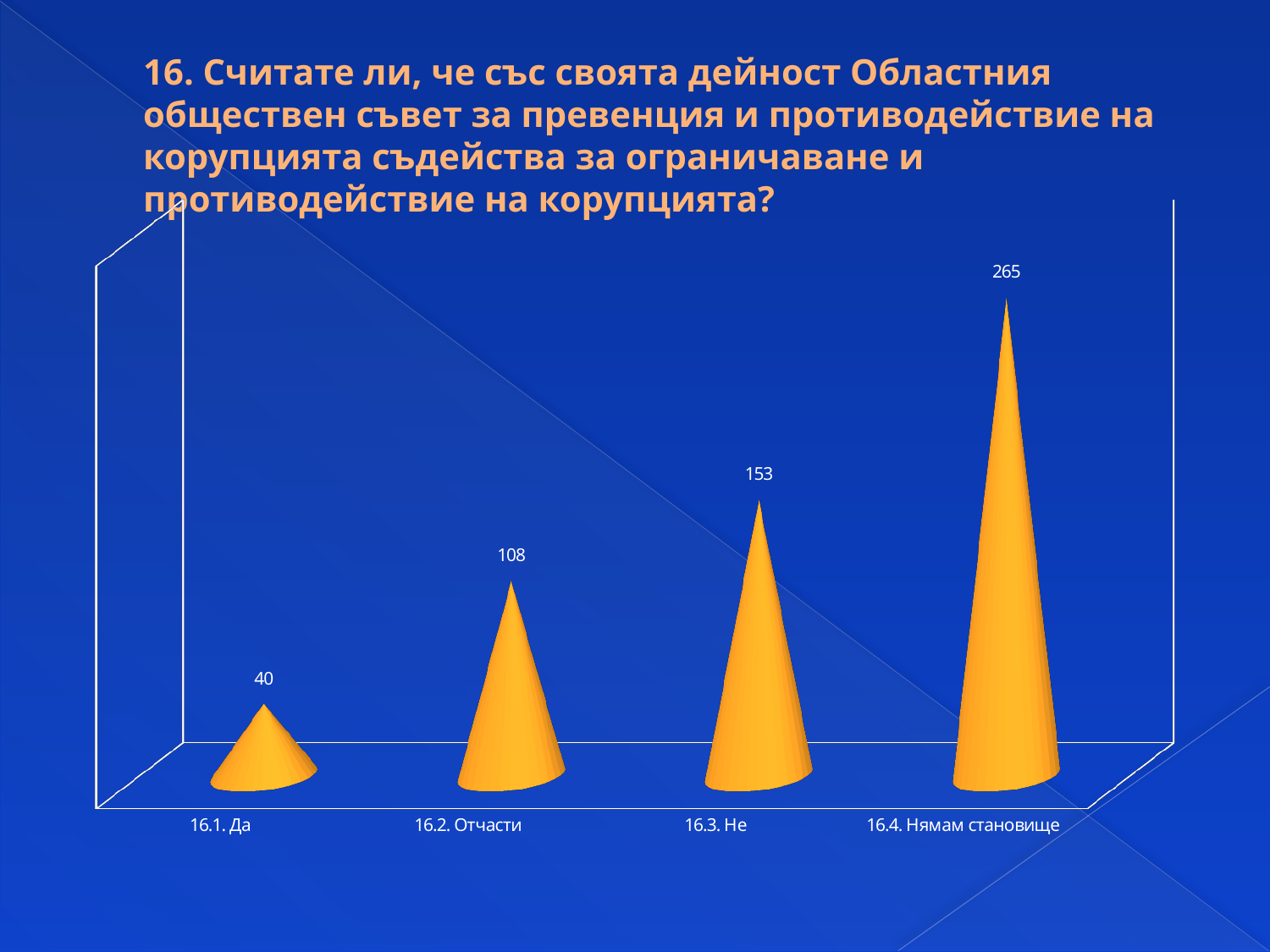
Do the values rise or fall from left to right along the x axis? rise What is the difference between the values for 16.4. Нямам становище and 16.3. Не? 112 What is the value for 16.4. Нямам становище? 265 What is the value for 16.1. Да? 40 What kind of chart is shown on the slide? bar chart Which category has the lowest value? 16.1. Да Which is larger, the value for 16.3. Не or the value for 16.2. Отчасти? 16.3. Не How many categories are shown on the chart? 4 What is the difference between the values for 16.2. Отчасти and 16.1. Да? 68 What is the value for 16.3. Не? 153 Which category has the highest value? 16.4. Нямам становище What is the value for 16.2. Отчасти? 108